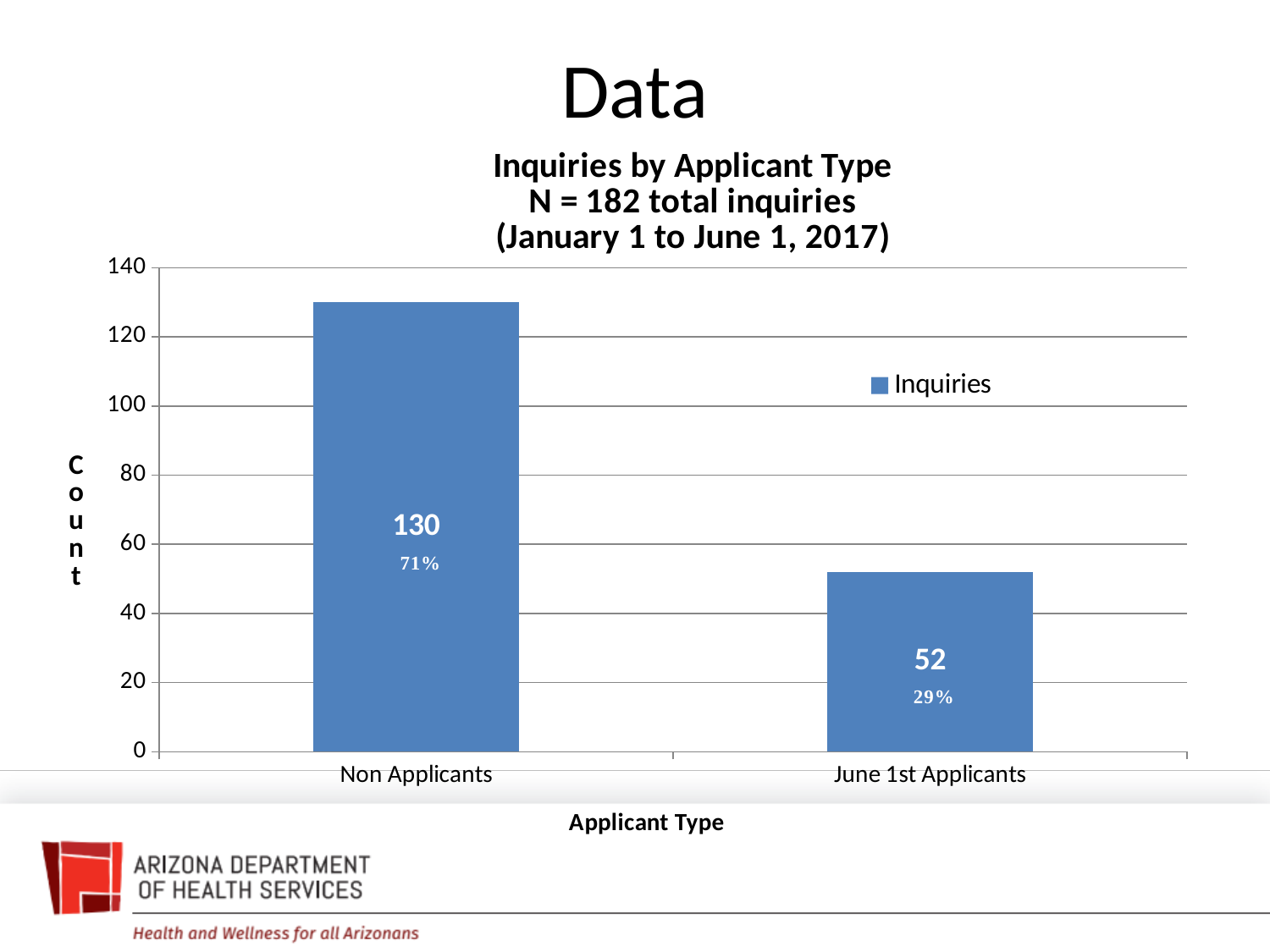
What is the total number of inquiries stated in the chart title? 182 What is the difference in inquiries between Non Applicants and June 1st Applicants? 78 Which applicant type had the most inquiries? Non Applicants Which applicant type had the fewest inquiries? June 1st Applicants What percentage of inquiries came from Non Applicants? 71% How many inquiries were there from June 1st Applicants? 52 What kind of chart is shown on the slide? Bar chart Which had more inquiries, Non Applicants or June 1st Applicants? Non Applicants How many inquiries were there from Non Applicants? 130 What percentage of inquiries came from June 1st Applicants? 29% How many applicant type categories are shown on the x axis? 2 How many series does the legend list? 1